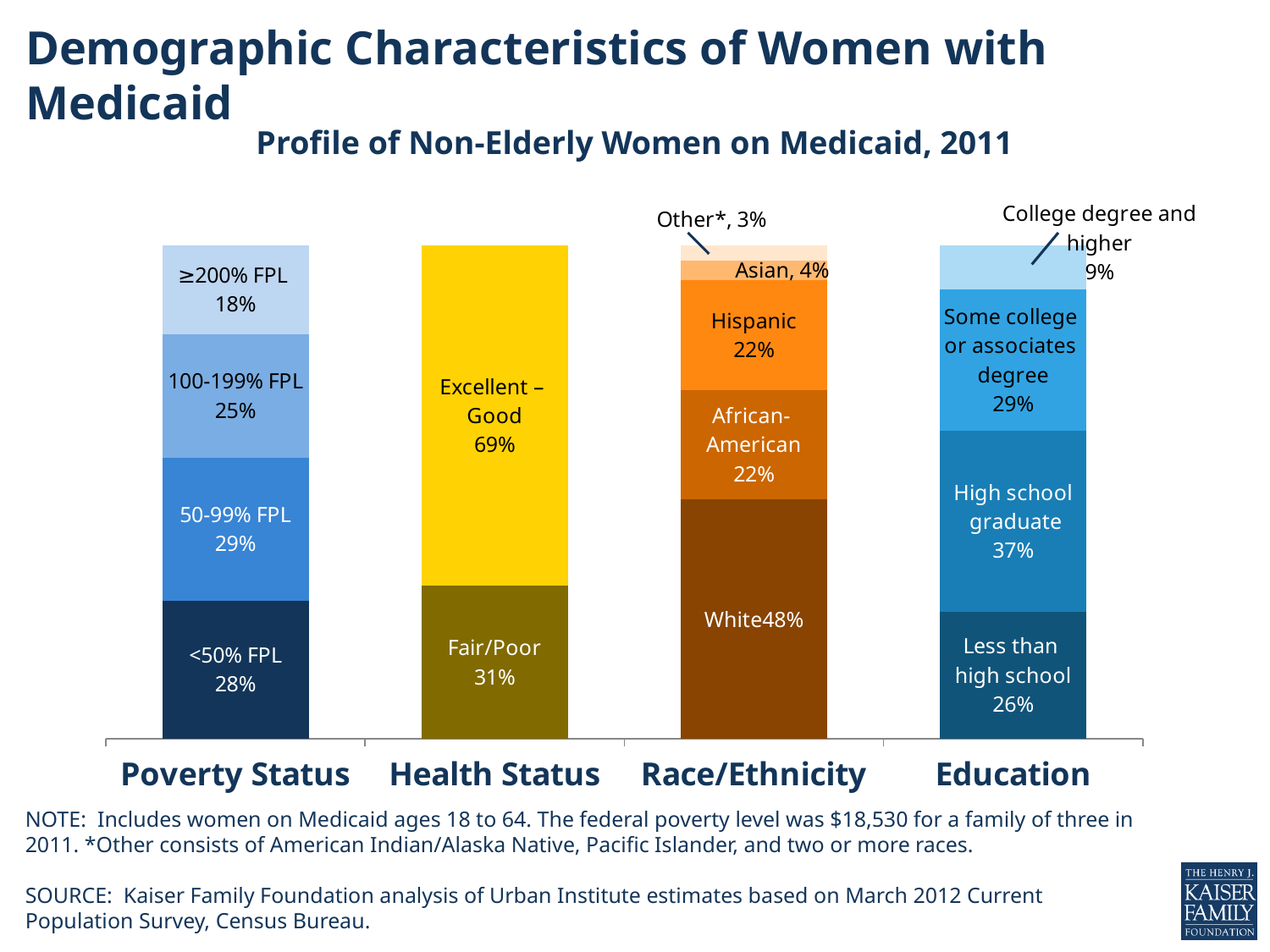
What percentage of non-elderly women on Medicaid are at ≥200% FPL? 18% What is the difference between the share of women who are high school graduates and the share with a college degree and higher? 28 percentage points Which poverty status group has the largest share of non-elderly women on Medicaid? 50-99% FPL What type of chart is shown on the slide? Stacked bar chart Which race/ethnicity group has the smallest share of non-elderly women on Medicaid? Other* What percentage of non-elderly women on Medicaid are White? 48% What share of non-elderly women on Medicaid have less than a high school education? 26% Which is larger: the share of women in Fair/Poor health or the share with some college or associates degree? Fair/Poor How many stacked bars are shown in the chart? 4 What is the total of the Health Status bar (Excellent – Good plus Fair/Poor)? 100% What is the title of the chart? Profile of Non-Elderly Women on Medicaid, 2011 What share of non-elderly women on Medicaid are in Excellent – Good health status? 69%